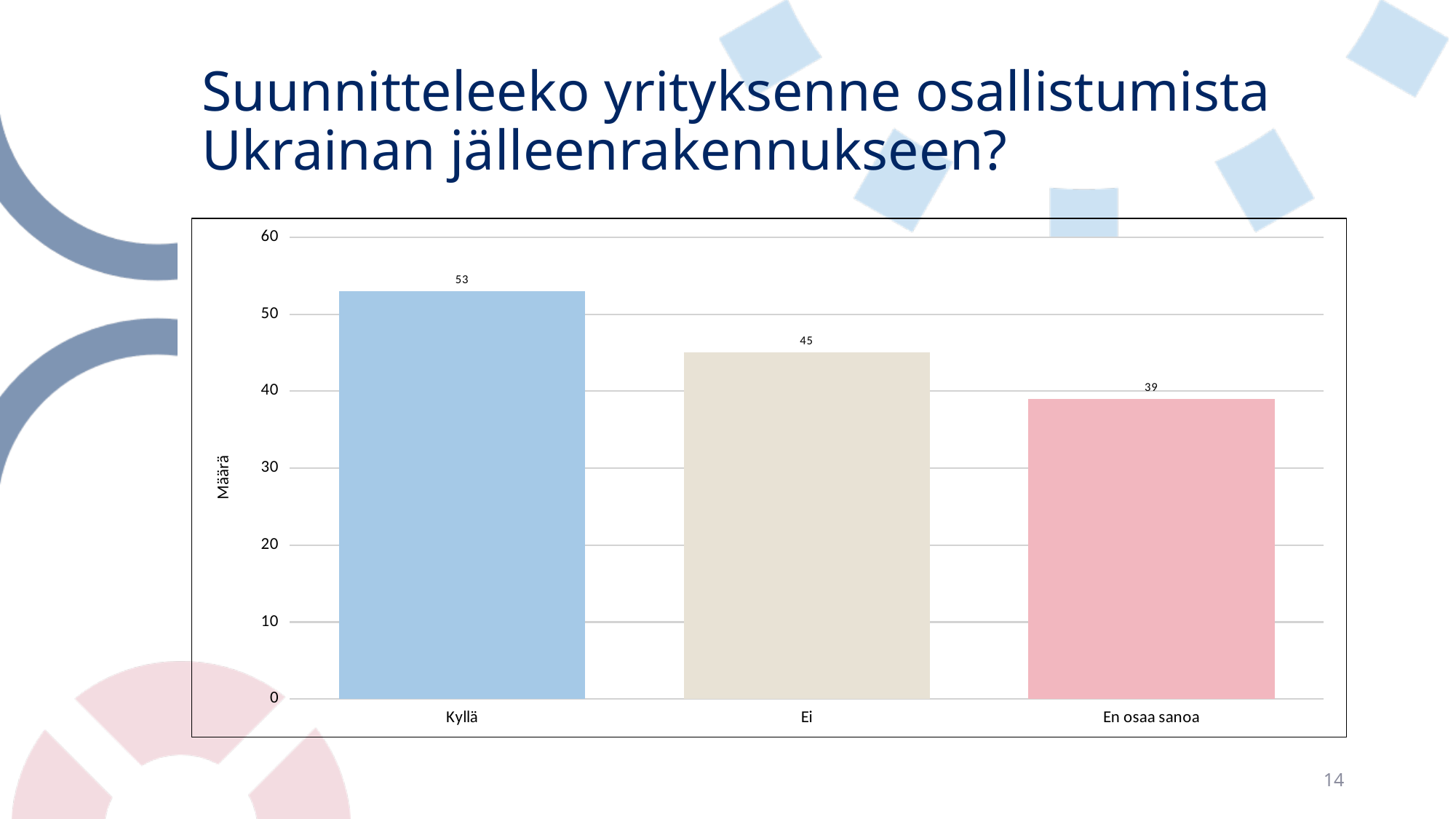
Which is larger, the value for Ei or the value for En osaa sanoa? Ei What is the value for Kyllä? 53 Which category has the highest value? Kyllä What is the label of the vertical axis? Määrä How many categories are shown in the chart? 3 What is the value for En osaa sanoa? 39 What is the value for Ei? 45 What kind of chart is shown on the slide? bar chart What is the difference between the values for Ei and En osaa sanoa? 6 Is the value for Kyllä greater or less than 50? greater What is the difference between the values for Kyllä and Ei? 8 Which category has the lowest value? En osaa sanoa